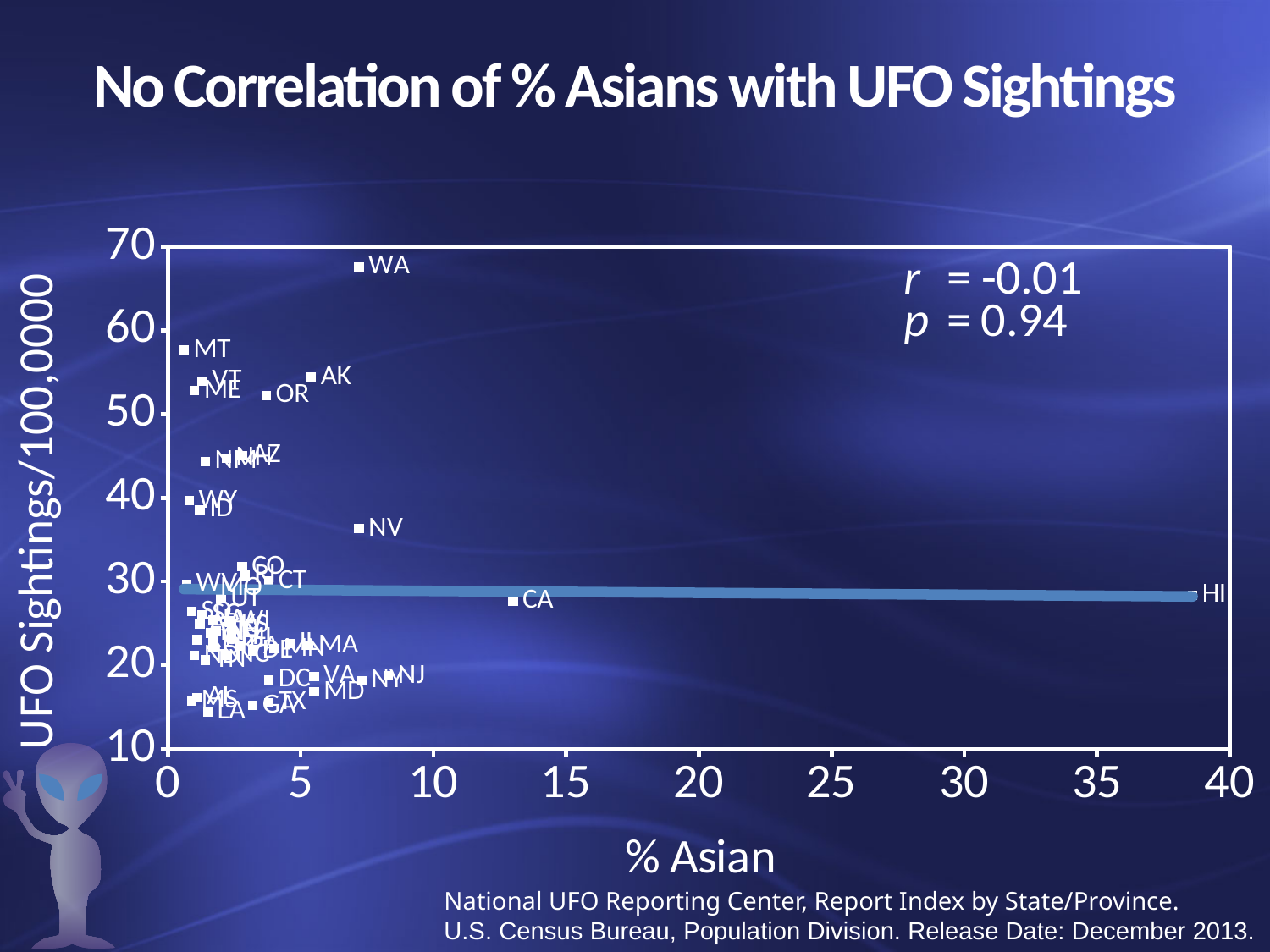
Is the UFO sightings value for NV greater or less than 40? less Which state has the highest UFO sightings per 100,000 on the chart? WA Is the UFO sightings value for WA greater or less than 60? greater Is the UFO sightings value for MT greater or less than 50? greater Which state has the highest % Asian on the chart? HI What is the label of the x axis? % Asian What correlation coefficient r is shown on the chart? -0.01 What kind of chart is shown on the slide? scatter plot Which has a higher % Asian, HI or CA? HI Which has more UFO sightings per 100,000, WA or NV? WA